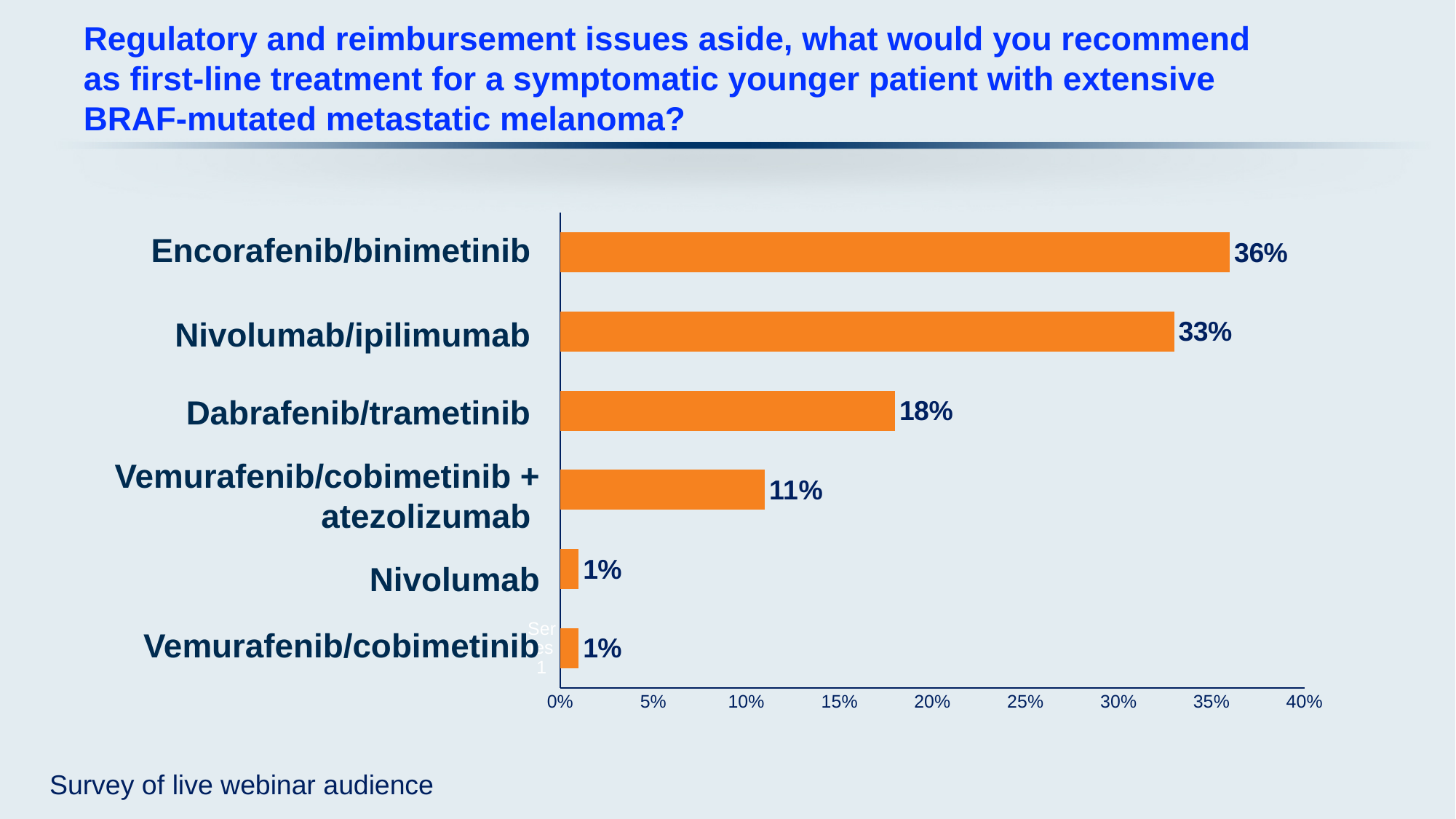
How many treatment options are shown in the chart? 6 What type of chart is shown on the slide? Bar chart Which treatment option received the highest percentage? Encorafenib/binimetinib What percentage is shown for Dabrafenib/trametinib? 18% What is the maximum value shown on the x axis of the chart? 40% What is the value for Vemurafenib/cobimetinib + atezolizumab? 11% What percentage of respondents recommended Encorafenib/binimetinib? 36% What is the difference between the values for Dabrafenib/trametinib and Vemurafenib/cobimetinib + atezolizumab? 7% Which has a larger value, Dabrafenib/trametinib or Vemurafenib/cobimetinib + atezolizumab? Dabrafenib/trametinib What is the value shown for Nivolumab/ipilimumab? 33% Is the value for Nivolumab/ipilimumab greater or less than 30%? greater What is the difference in percentage points between Encorafenib/binimetinib and Nivolumab/ipilimumab? 3%